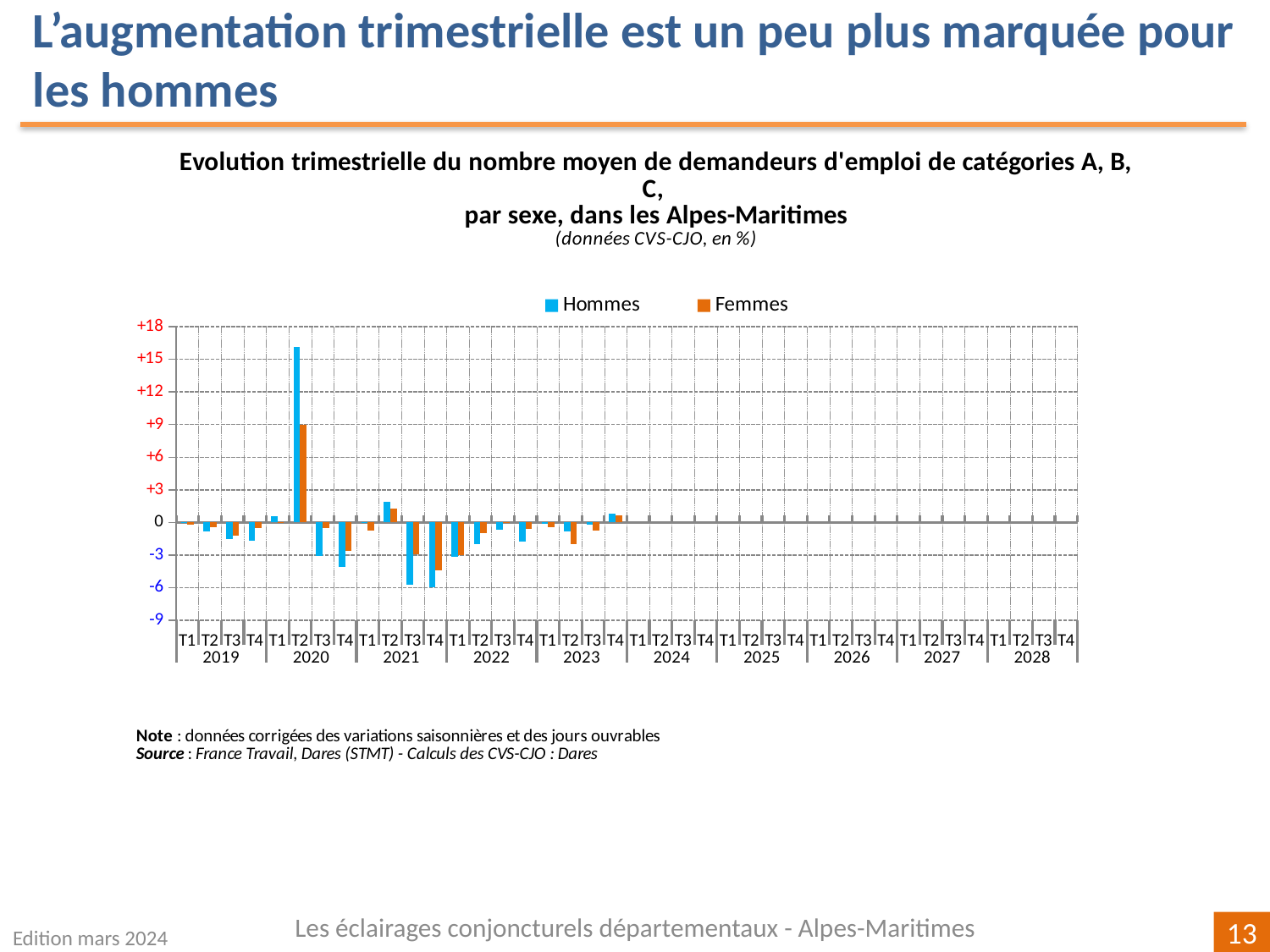
Is the value for Hommes in T3 2021 greater or less than -3? less In which quarter does the Femmes series reach its highest value? T2 2020 Is the value for Femmes in T2 2020 greater or less than 6? greater In which quarter does the Hommes series reach its highest value? T2 2020 How many years are labelled along the x axis? 10 How many series does the legend list? 2 In T4 2020, which series has the higher value, Hommes or Femmes? Femmes In T2 2020, which series has the larger value, Hommes or Femmes? Hommes Which series is shown in orange in the legend? Femmes Is the value for Hommes in T2 2020 greater or less than 12? greater What kind of chart is shown on the slide? bar chart